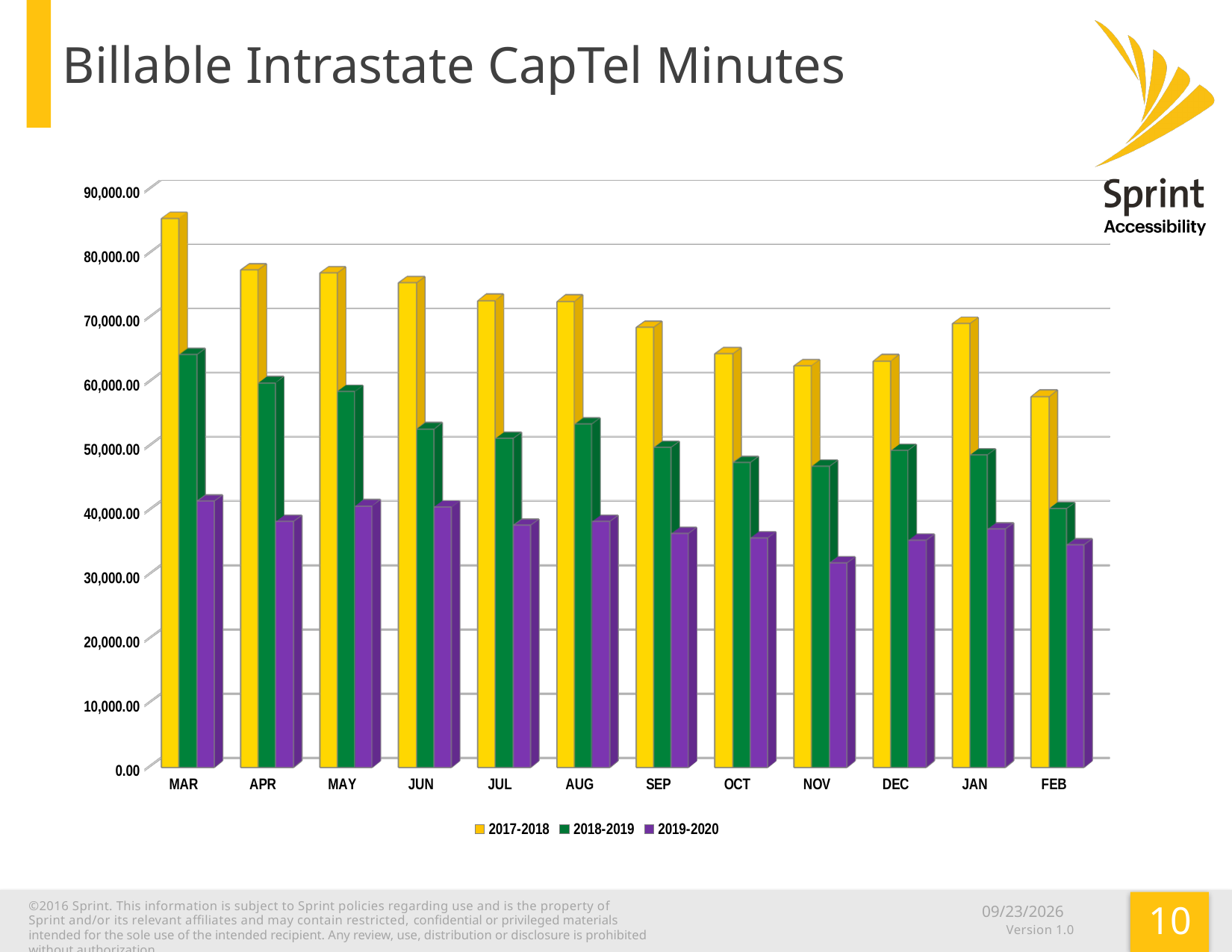
Is the value for MAR in the 2017-2018 series greater or less than 80,000.00? greater For MAR, which series has the larger value: 2018-2019 or 2019-2020? 2018-2019 How many series does the legend list? 3 What kind of chart is shown on the slide? Bar chart How many months are shown on the x axis? 12 Which month has the lowest value for the 2017-2018 series? FEB Is the value for NOV in the 2019-2020 series greater or less than 40,000.00? less Do the 2017-2018 values rise or fall from MAR to OCT? fall Which month has the highest value for the 2017-2018 series? MAR Which month has the lowest value for the 2019-2020 series? NOV Is the value for FEB in the 2018-2019 series greater or less than 50,000.00? less Which month has the highest value for the 2018-2019 series? MAR